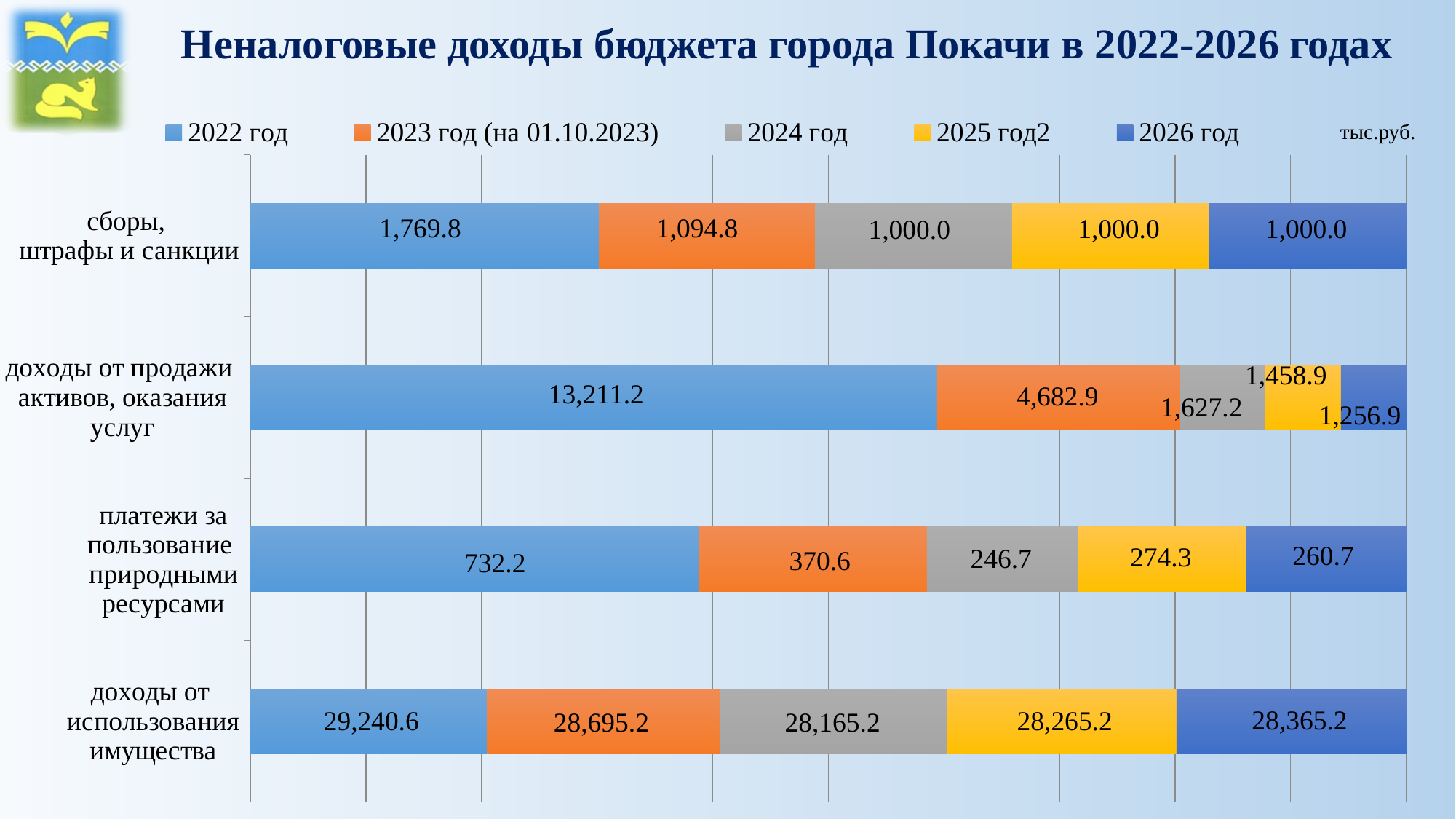
How many series does the legend list? 5 Which year has the highest value in the category 'доходы от продажи активов, оказания услуг'? 2022 год What is the value for 2022 год in the category 'сборы, штрафы и санкции'? 1,769.8 How many categories are plotted on the chart? 4 Do the values for 'доходы от продажи активов, оказания услуг' rise or fall from 2022 год to 2026 год? fall What is the value for 2023 год (на 01.10.2023) in the category 'доходы от продажи активов, оказания услуг'? 4,682.9 What is the value for 2026 год in the category 'доходы от использования имущества'? 28,365.2 What is the difference between the 2022 год and 2023 год values in the category 'платежи за пользование природными ресурсами'? 361.6 In the category 'платежи за пользование природными ресурсами', which is larger: the value for 2025 год or for 2026 год? 2025 год What is the value for 2024 год in the category 'платежи за пользование природными ресурсами'? 246.7 What kind of chart is shown on the slide? bar chart What is the total of the stacked bar for 'сборы, штрафы и санкции' across all five years? 5,864.6